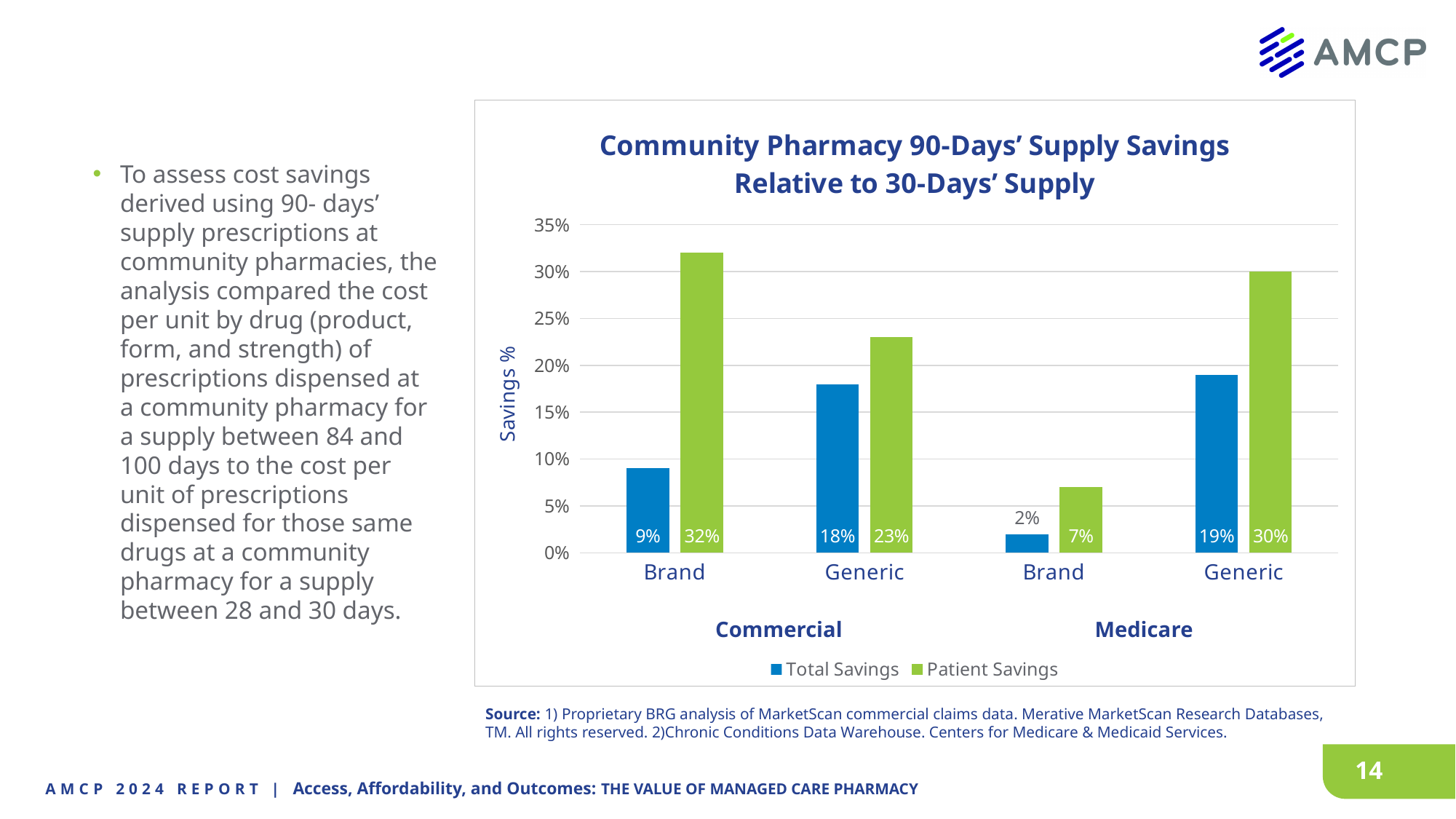
What is the difference between Patient Savings and Total Savings for Commercial Brand? 23% What kind of chart is shown on the slide? Bar chart How many categories are shown on the x axis? 4 How many series does the legend list? 2 Which category has the lowest Total Savings? Medicare Brand Which is larger, Total Savings for Commercial Generic or Total Savings for Medicare Generic? Total Savings for Medicare Generic What is the Patient Savings value for Medicare Generic? 30% What is the Total Savings value for Medicare Brand? 2% Which category has the highest Patient Savings? Commercial Brand What is the title of the chart? Community Pharmacy 90-Days' Supply Savings Relative to 30-Days' Supply What is the Total Savings value for Commercial Brand? 9% What is the Patient Savings value for Commercial Generic? 23%